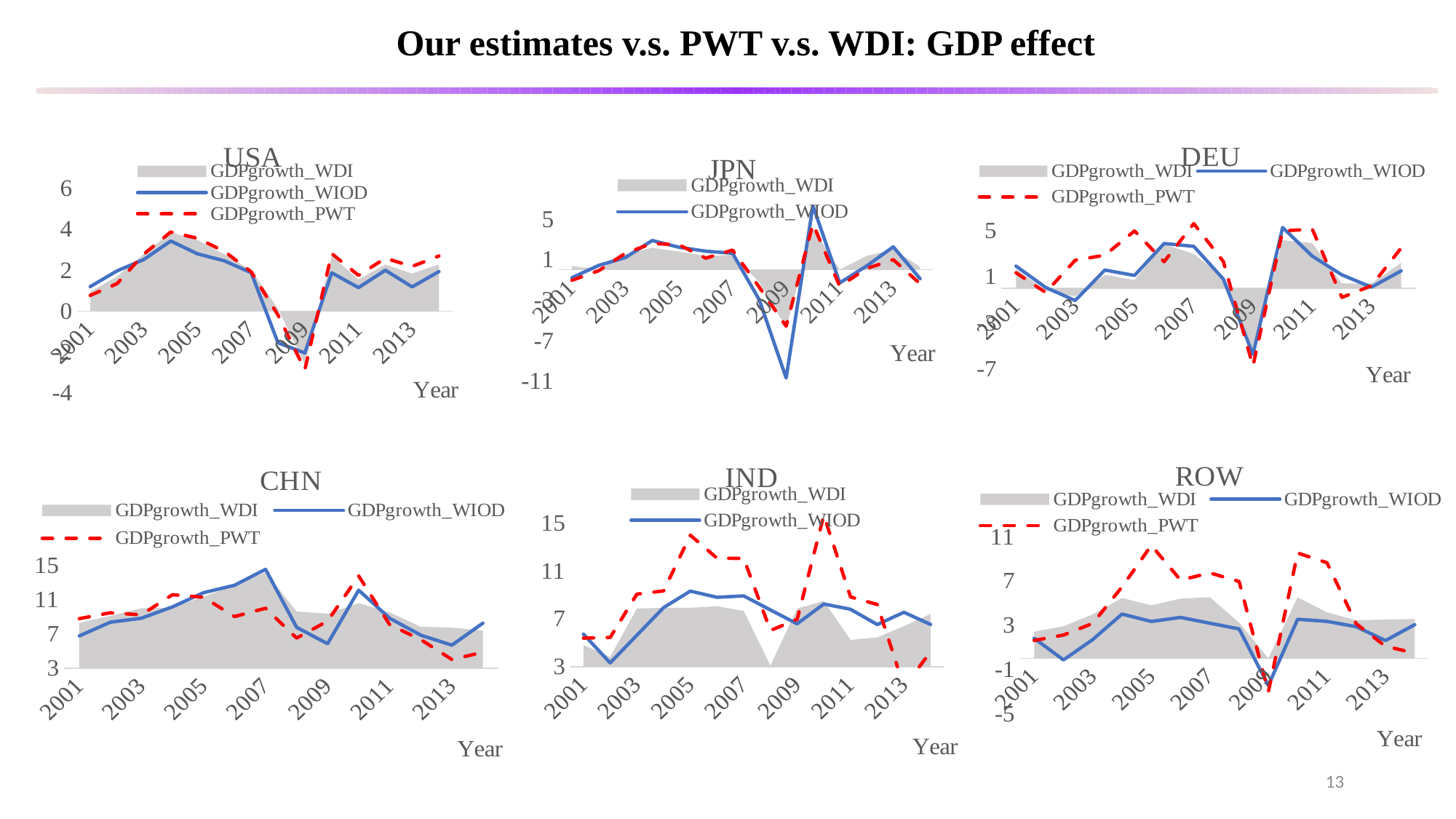
In the IND chart, is the GDPgrowth_PWT value for 2010 greater or less than 11? greater In the ROW chart, is the GDPgrowth_WIOD value for 2009 greater or less than 3? less In the USA chart, how many series does the legend list? 3 In the USA chart, does the GDPgrowth_WIOD series rise or fall between 2007 and 2009? fall In the USA chart, which series is drawn as a red dashed line? GDPgrowth_PWT In the CHN chart, is the GDPgrowth_WIOD series drawn as a line or as bars? a line In the DEU chart, is the GDPgrowth_WIOD value for 2009 greater or less than -3? less In the CHN chart, which year has the highest GDPgrowth_WIOD value? 2007 How many charts are shown on the slide? 6